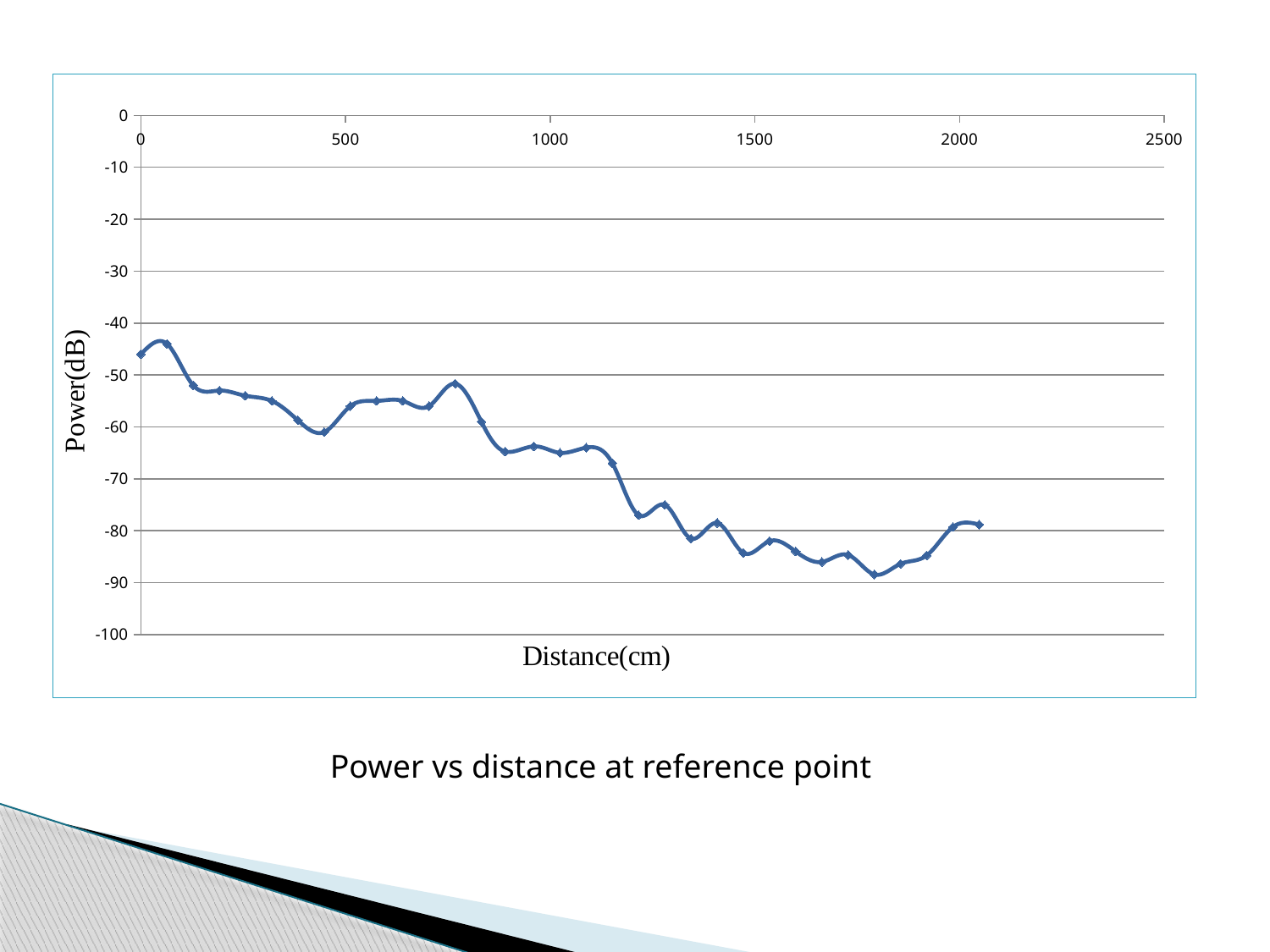
Which is larger, the power at 1000 cm or the power at 1500 cm? the power at 1000 cm Is the lowest point on the line greater or less than -80 dB? less Overall, does the power rise or fall as distance increases along the x axis? fall Is the power value at a distance of 0 cm greater or less than -50 dB? greater Is the power value at a distance of 1500 cm greater or less than -80 dB? less What is the label of the vertical axis? Power(dB) What is the label of the horizontal axis? Distance(cm) Which is larger, the power at 0 cm or the power at 2000 cm? the power at 0 cm What kind of chart is shown on the slide? line chart